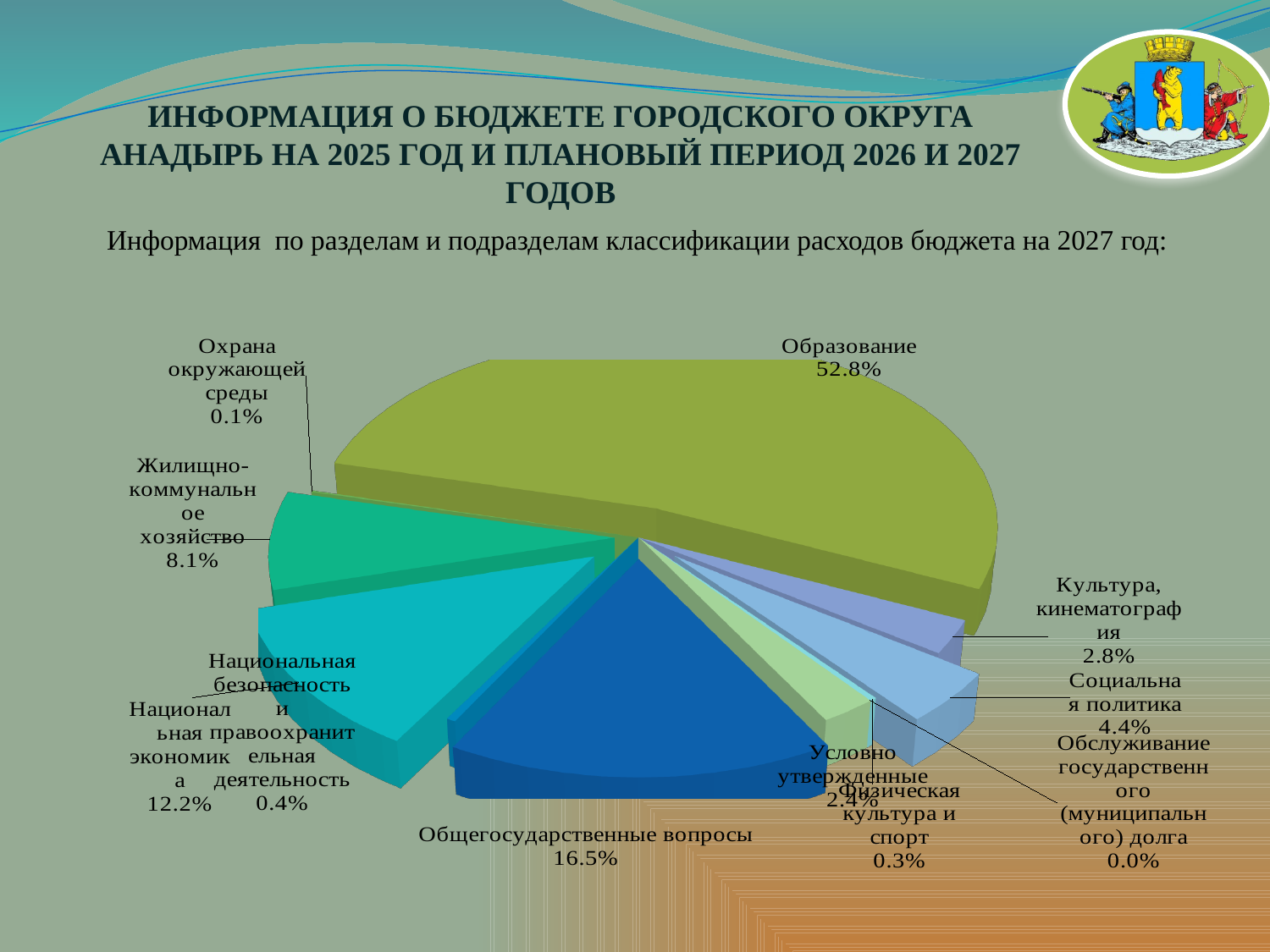
Which category has the smallest share shown on the chart? Обслуживание государственного (муниципального) долга What is the value shown for Общегосударственные вопросы? 16.5% What is the value for Социальная политика? 4.4% Which is larger: the share for Культура, кинематография or the share for Условно утвержденные? Культура, кинематография What is the difference between the shares of Общегосударственные вопросы and Национальная экономика? 4.3% What share of the 2027 budget expenditure goes to Образование? 52.8% How many categories are shown in the pie chart? 11 Which category has the largest slice of the pie? Образование What share is shown for Охрана окружающей среды? 0.1% What kind of chart is shown on the slide? pie chart Which year does the chart's expenditure breakdown refer to, according to the text above it? 2027 What percentage is shown for Жилищно-коммунальное хозяйство? 8.1%